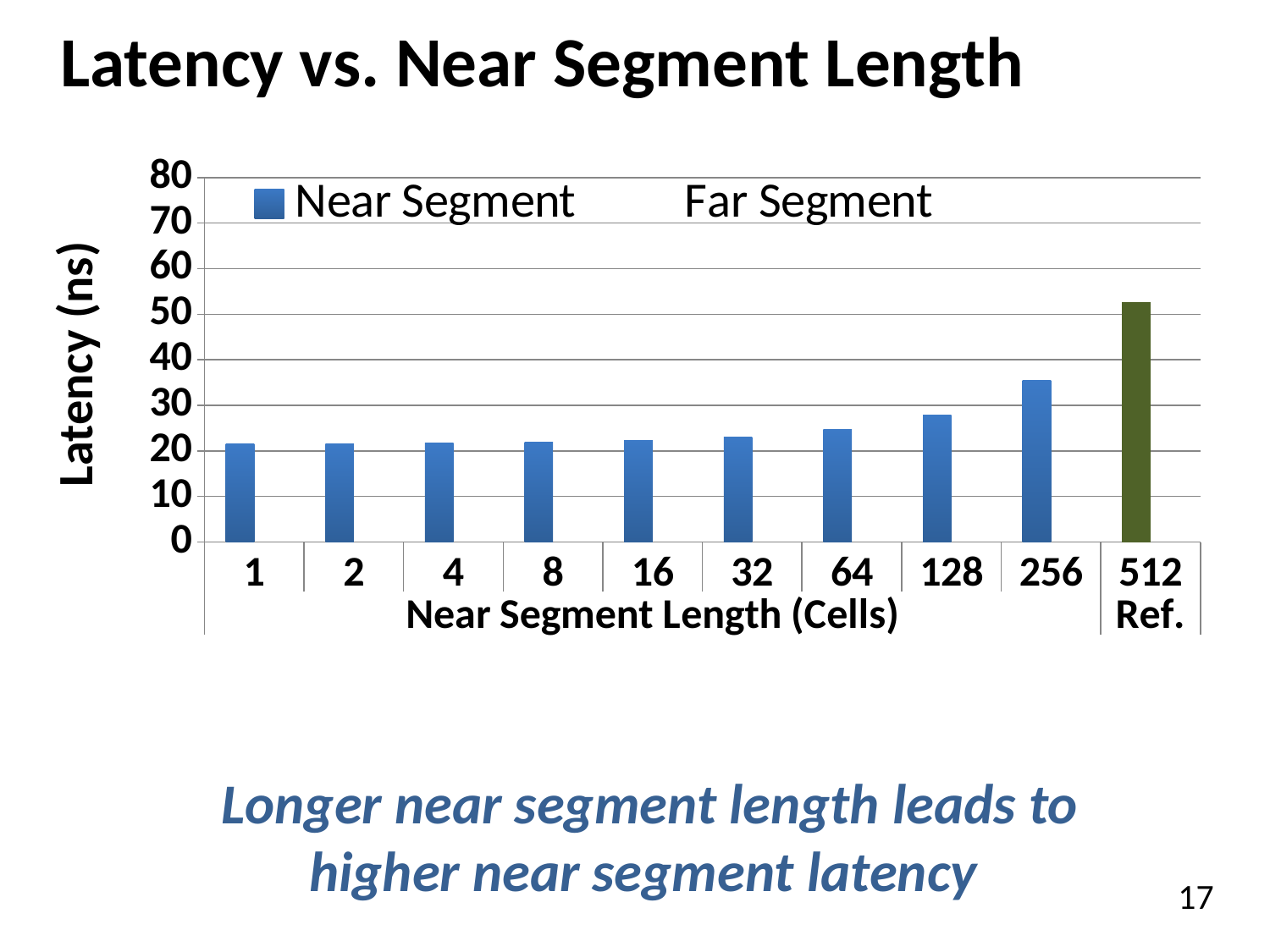
What kind of chart is shown on the slide? bar chart What is the label of the y axis? Latency (ns) Is the latency for 128 greater or less than 30? less Is the latency for near segment length 1 greater or less than 20? greater Is the latency for 256 greater or less than 40? less Which category has the highest latency? 512 Ref. Which has the higher latency, near segment length 128 or 256? 256 Do the near segment latency values rise or fall as near segment length increases along the x axis? rise How many bars (categories) are plotted along the x axis? 10 How many series does the legend list? 2